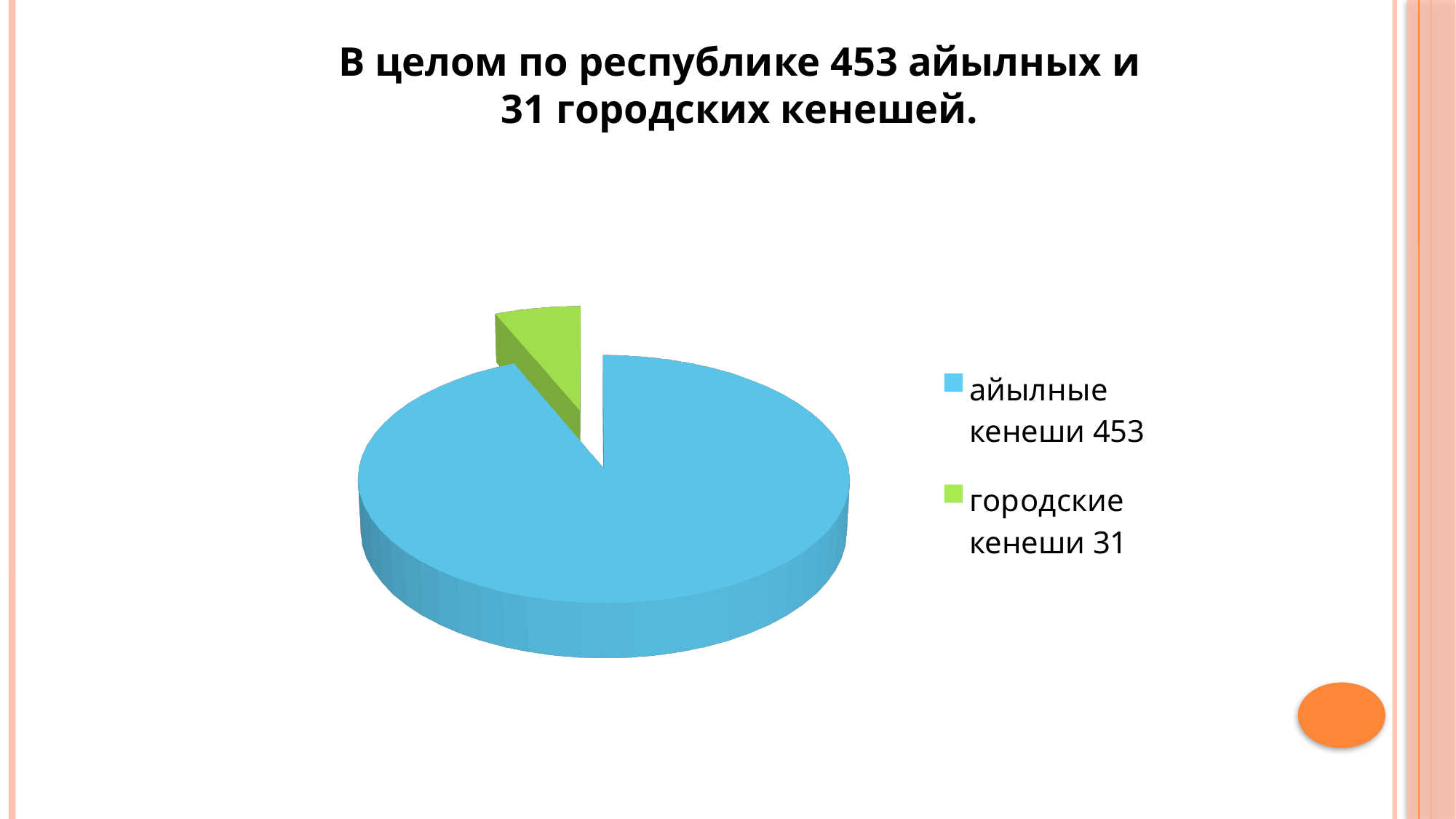
What is the value for городские кенеши? 31 How many slices does the pie chart have? 2 What is the title of the chart? В целом по республике 453 айылных и 31 городских кенешей. What colour is the slice for городские кенеши? Green What is the total of the two values shown in the pie chart? 484 What is the value for айылные кенеши? 453 What is the difference between the values for айылные кенеши and городские кенеши? 422 Which category has the smallest slice of the pie? городские кенеши What kind of chart is shown on the slide? Pie chart Which is larger, the value for айылные кенеши or for городские кенеши? айылные кенеши How many entries does the legend list? 2 Which category has the largest slice of the pie? айылные кенеши